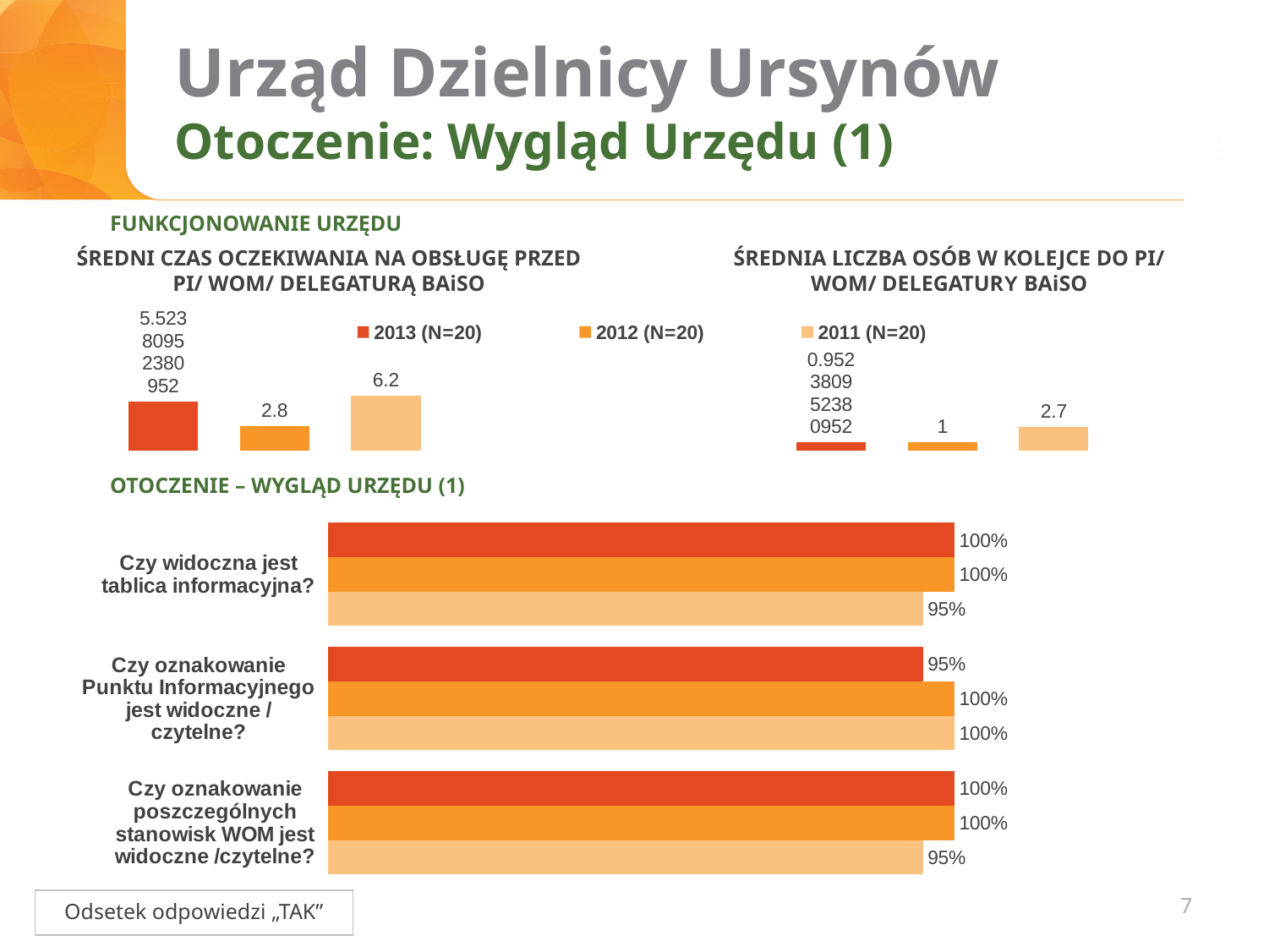
In the chart 'ŚREDNI CZAS OCZEKIWANIA NA OBSŁUGĘ PRZED PI/ WOM/ DELEGATURĄ BAiSO', what is the difference between the 2011 and 2012 values? 3.4 In the bottom chart 'OTOCZENIE – WYGLĄD URZĘDU (1)', what is the value of the bottom (light orange, 2011) bar for 'Czy widoczna jest tablica informacyjna?'? 95% In the chart 'ŚREDNIA LICZBA OSÓB W KOLEJCE DO PI/ WOM/ DELEGATURY BAiSO', what is the difference between the 2011 and 2012 values? 1.7 In the chart 'ŚREDNIA LICZBA OSÓB W KOLEJCE DO PI/ WOM/ DELEGATURY BAiSO', what is the value for 2011 (N=20)? 2.7 How many series does the legend above the top charts list? 3 In the chart 'ŚREDNIA LICZBA OSÓB W KOLEJCE DO PI/ WOM/ DELEGATURY BAiSO', what is the value for 2012 (N=20)? 1 In the bottom chart 'OTOCZENIE – WYGLĄD URZĘDU (1)', what is the value of the top (dark red, 2013) bar for 'Czy oznakowanie Punktu Informacyjnego jest widoczne / czytelne?'? 95% In the chart 'ŚREDNI CZAS OCZEKIWANIA NA OBSŁUGĘ PRZED PI/ WOM/ DELEGATURĄ BAiSO', which year has the lowest value? 2012 (N=20) In the chart 'ŚREDNIA LICZBA OSÓB W KOLEJCE DO PI/ WOM/ DELEGATURY BAiSO', which year has the highest value? 2011 (N=20) In the chart 'ŚREDNI CZAS OCZEKIWANIA NA OBSŁUGĘ PRZED PI/ WOM/ DELEGATURĄ BAiSO', what is the value for 2011 (N=20)? 6.2 How many question categories are shown in the bottom chart 'OTOCZENIE – WYGLĄD URZĘDU (1)'? 3 In the chart 'ŚREDNI CZAS OCZEKIWANIA NA OBSŁUGĘ PRZED PI/ WOM/ DELEGATURĄ BAiSO', what is the value for 2012 (N=20)? 2.8